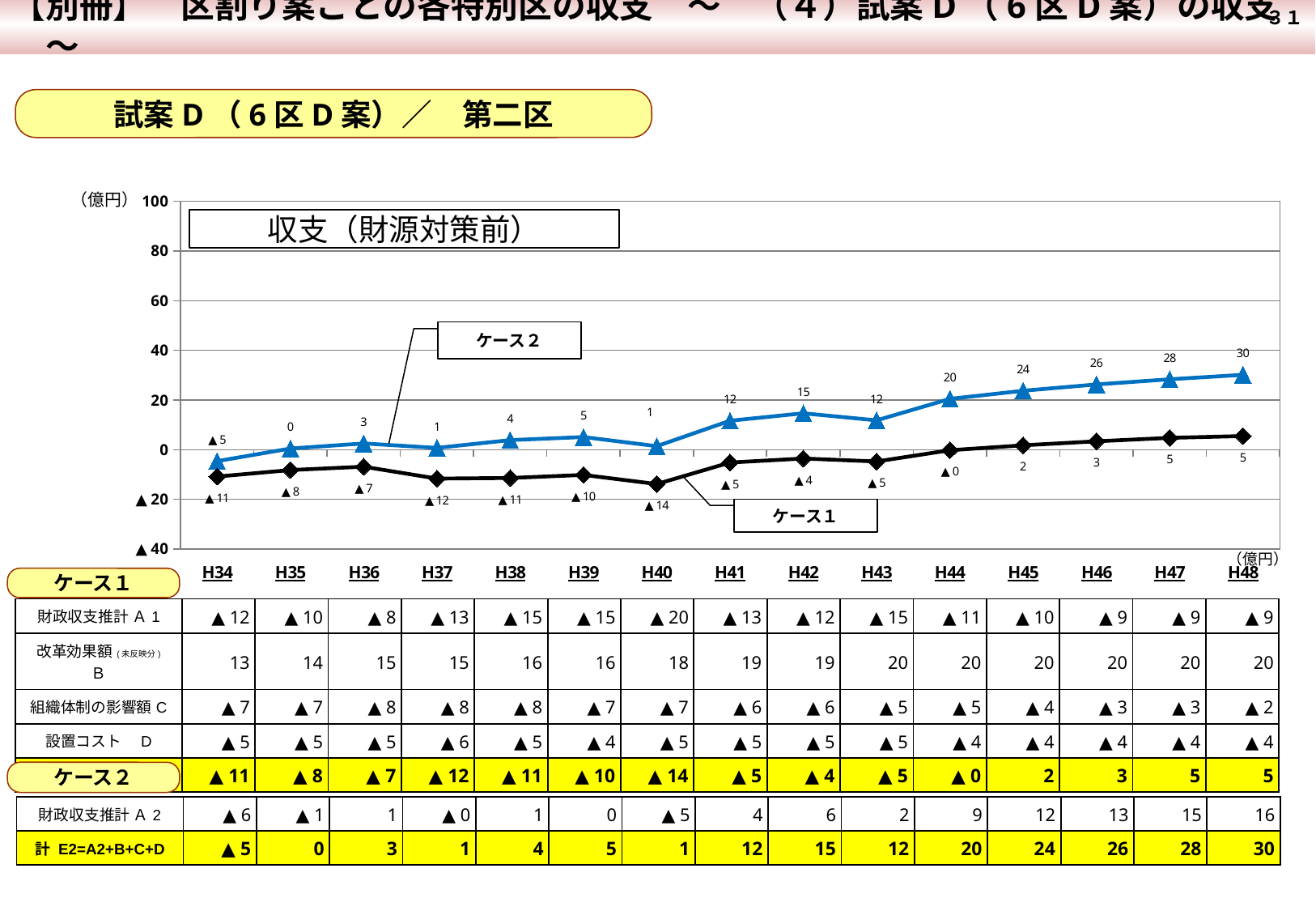
Is the value for ケース2 at H48 greater or less than 20? greater Which series has the larger value at H41, ケース1 or ケース2? ケース2 At which year is ケース1 at its lowest value? H40 At which year does ケース2 reach its highest value? H48 What is the value of ケース2 at H48? 30 What kind of chart is shown on the slide? line chart What is the difference between ケース2 and ケース1 at H48? 25 How many years (data points) are plotted on the x axis? 15 What is the value of ケース2 at H42? 15 How many series are plotted in the chart? 2 What is the value of ケース1 at H40? ▲14 What is the title shown inside the chart area? 収支（財源対策前）